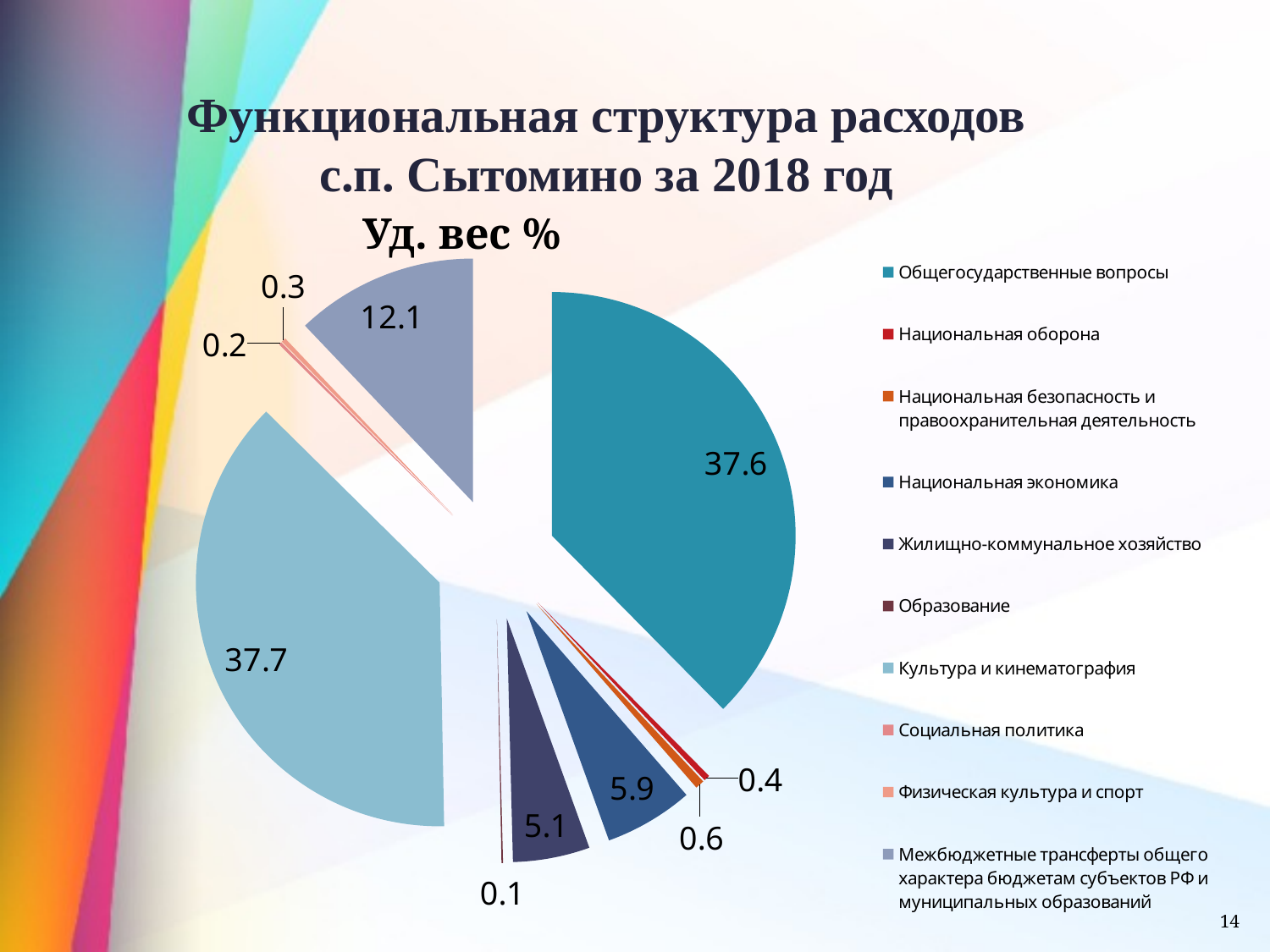
What is the value for Общегосударственные вопросы? 37.6 Which is larger, the value for Национальная экономика or the value for Жилищно-коммунальное хозяйство? Национальная экономика What is the difference between the values for Межбюджетные трансферты (12.1) and Национальная экономика (5.9)? 6.2 What kind of chart is shown on the slide? pie chart How many categories does the legend list? 10 What is the value for Жилищно-коммунальное хозяйство? 5.1 What is the difference between the values for Национальная безопасность и правоохранительная деятельность and Национальная оборона? 0.2 What is the value for Межбюджетные трансферты общего характера бюджетам субъектов РФ и муниципальных образований? 12.1 What is the value for Культура и кинематография? 37.7 What is the title of the chart? Уд. вес % What is the value for Национальная экономика? 5.9 Which category has the smallest value? Образование